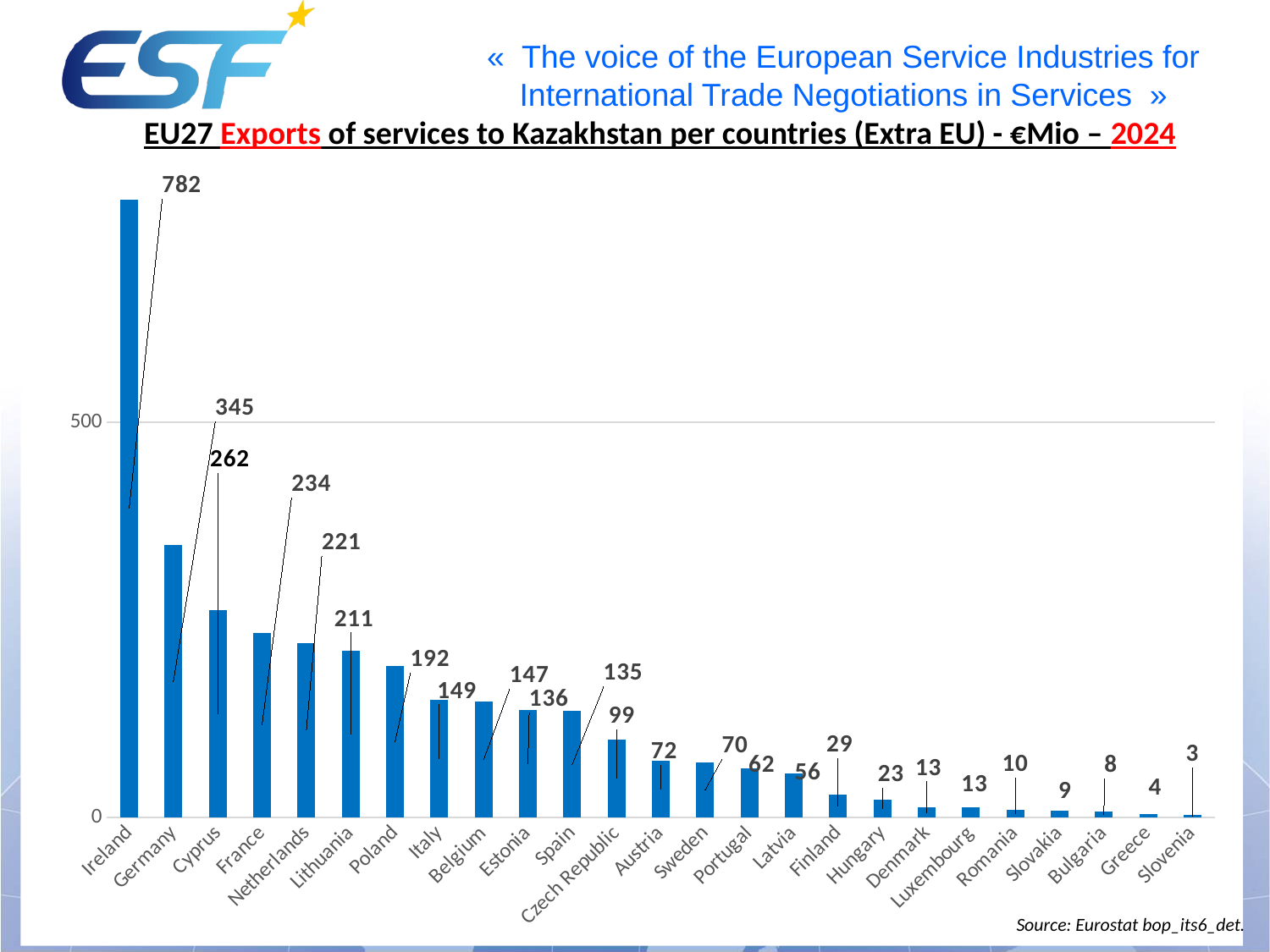
What is the value for Ireland? 782 How many countries are shown on the chart? 25 What is the value for Czech Republic? 99 Which country has the lowest value? Slovenia Which country has the highest value? Ireland What is the value for Germany? 345 What is the value for Finland? 29 Which is larger, the value for Cyprus or the value for Poland? Cyprus What is the difference between the values for Ireland and Germany? 437 What is the title of the chart? EU27 Exports of services to Kazakhstan per countries (Extra EU) - €Mio – 2024 What kind of chart is shown on the slide? Bar chart What is the difference between the values for France and Netherlands? 13